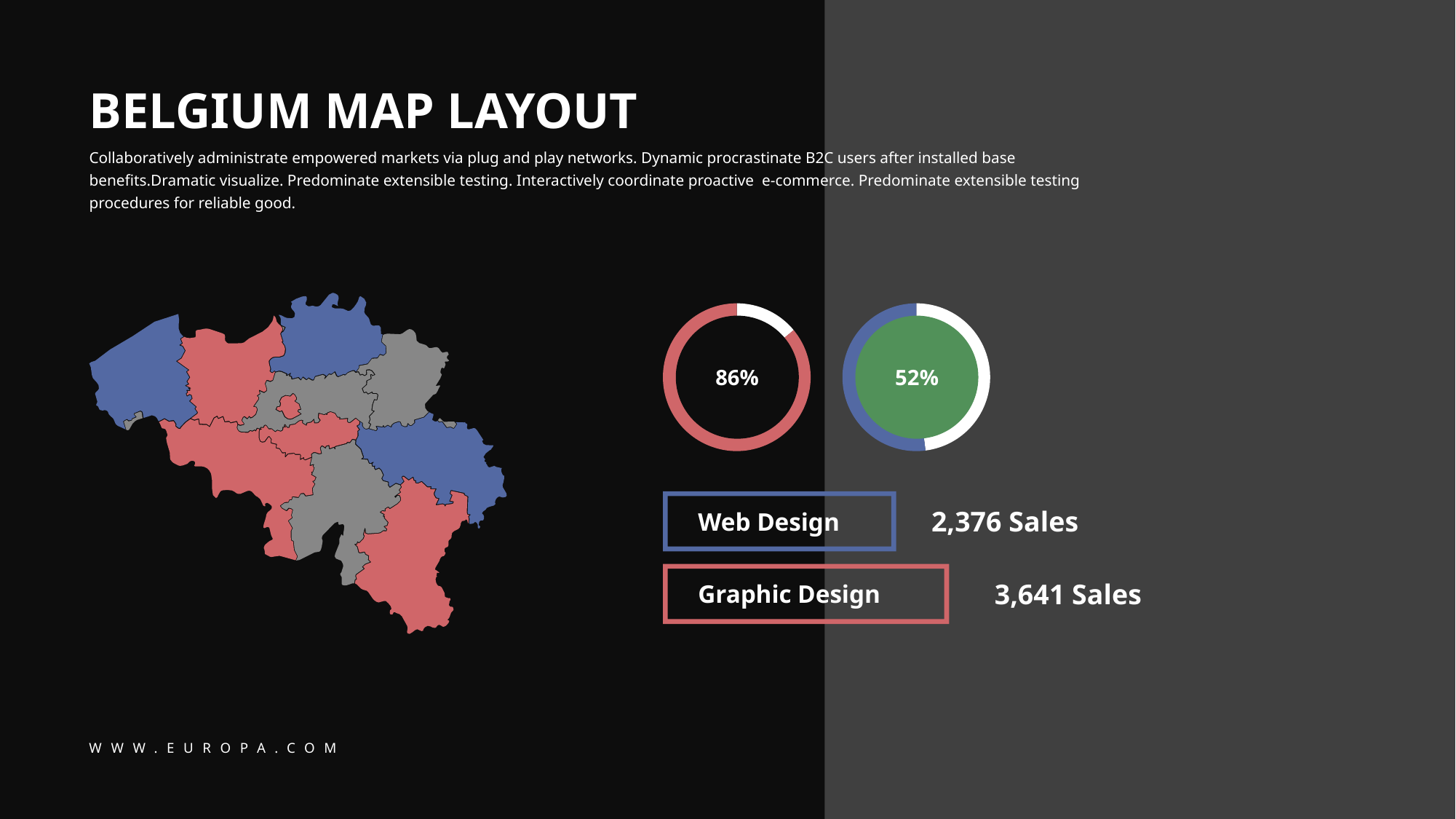
What percentage is shown in the centre of the right donut chart? 52% What percentage is shown in the centre of the left donut chart? 86% Is the value shown in the right donut chart greater or less than 75%? less What colour is the filled portion of the ring in the left donut chart? Red How many sales are listed next to the Graphic Design label below the donut charts? 3,641 Sales What colour is the centre of the right donut chart filled with? Green What kind of charts are the two circular graphics on the right side of the slide? Donut charts What is the difference in percentage points between the left donut chart (86%) and the right donut chart (52%)? 34 percentage points How many donut charts are on the slide? 2 Which donut chart shows the larger percentage, the left one or the right one? The left one How many sales are listed next to the Web Design label below the donut charts? 2,376 Sales Is the value shown in the left donut chart greater or less than 50%? greater